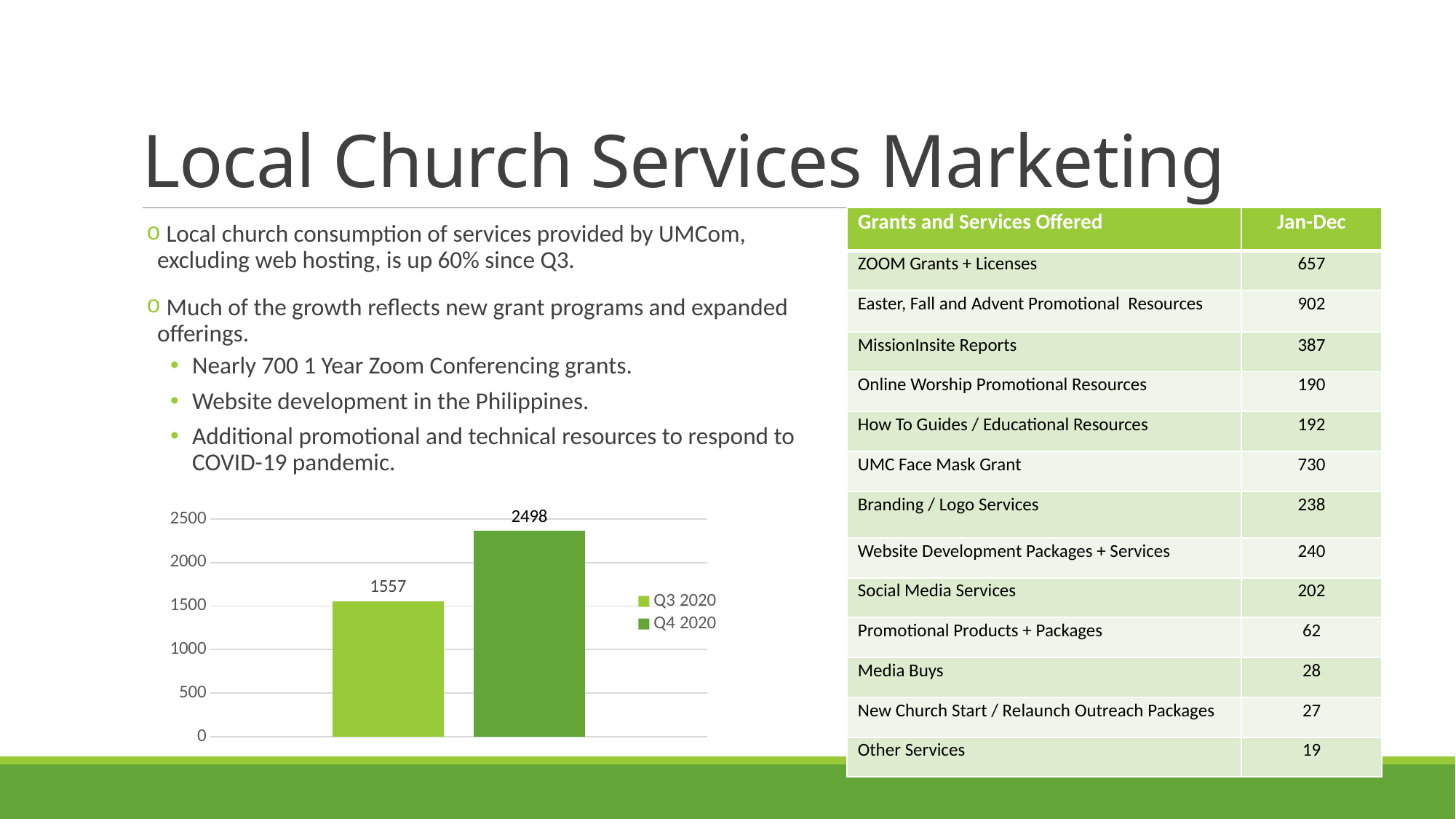
What is the highest value labelled on the vertical axis of the bar chart? 2500 Which series has the highest value in the bar chart? Q4 2020 What is the value for Q4 2020 in the bar chart? 2498 What kind of chart is shown on the slide? bar chart Is the value for Q3 2020 in the bar chart greater or less than 2000? less What is the difference between the Q4 2020 and Q3 2020 values in the bar chart? 941 How many series does the legend of the bar chart list? 2 Which series has the lowest value in the bar chart? Q3 2020 Do the values in the bar chart rise or fall from Q3 2020 to Q4 2020? rise What is the value for Q3 2020 in the bar chart? 1557 Which series has the higher value in the bar chart, Q3 2020 or Q4 2020? Q4 2020 Is the value for Q4 2020 in the bar chart greater or less than 2000? greater